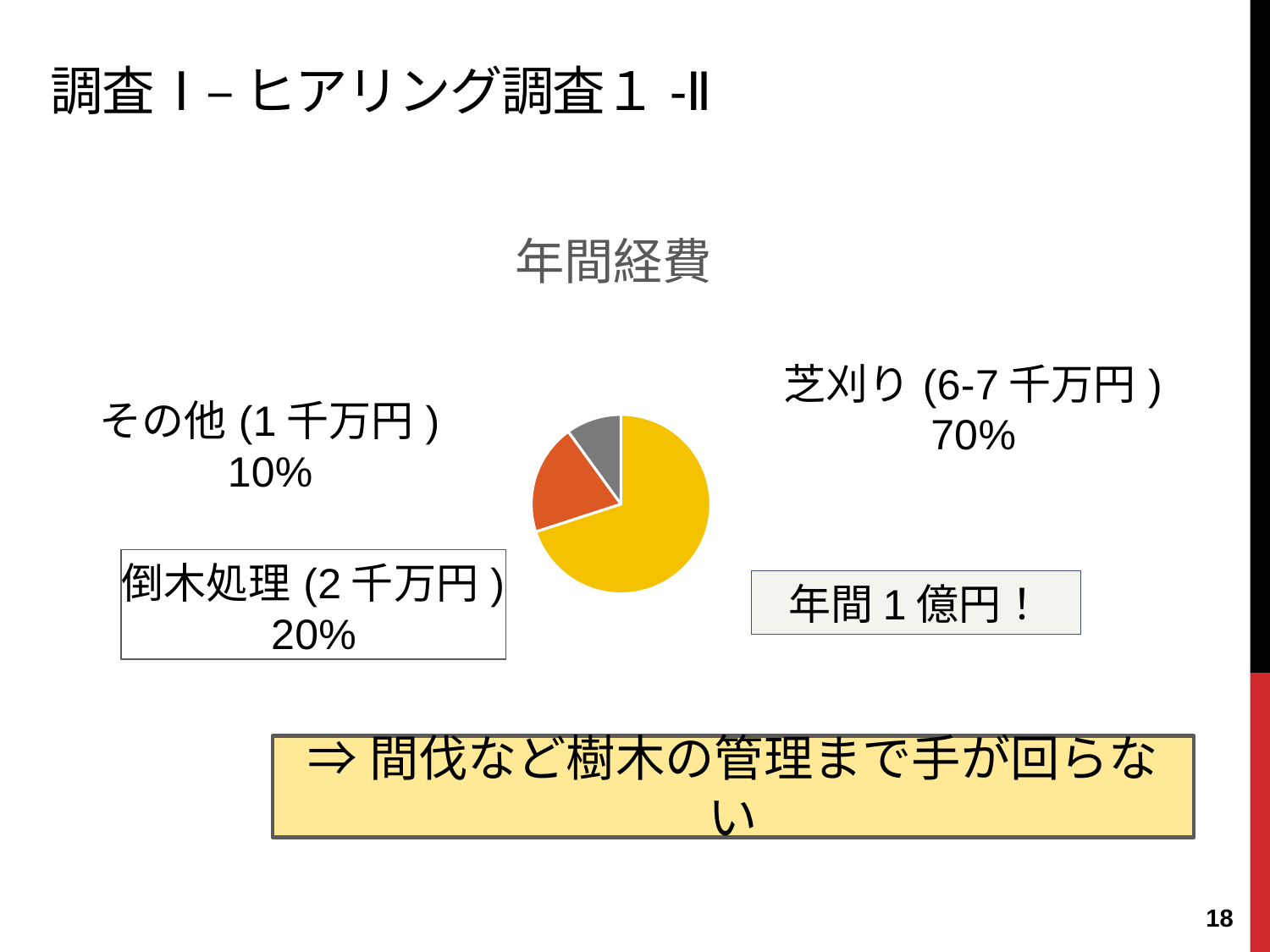
Which is larger, the share for 倒木処理 or the share for その他? 倒木処理 What share of the pie does その他 account for? 10% Which category has the smallest share of the pie? その他 What share of the pie does 倒木処理 account for? 20% What colour is the slice for 芝刈り? yellow What is the difference in percentage points between the share for 芝刈り and the share for 倒木処理? 50 What amount in yen is shown next to the 倒木処理 label? 2千万円 How many slices does the pie chart have? 3 What kind of chart is shown on the slide? pie chart What share of the pie does 芝刈り account for? 70% Which category has the largest share of the pie? 芝刈り What is the title of the chart? 年間経費